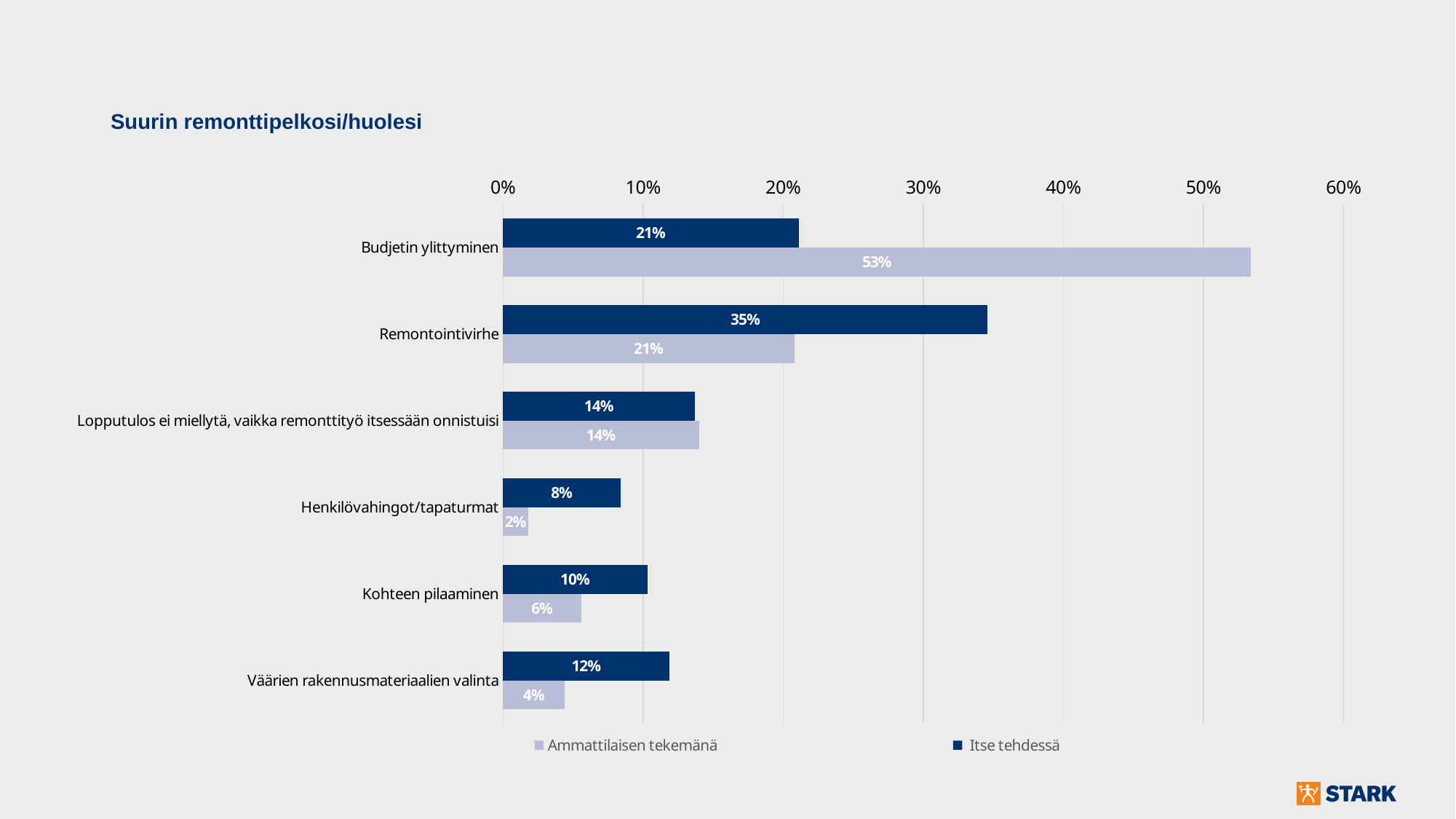
What is the value for "Remontointivirhe" in the "Itse tehdessä" series? 35% Is the "Ammattilaisen tekemänä" value for "Budjetin ylittyminen" greater or less than 50%? greater What is the title of the chart? Suurin remonttipelkosi/huolesi Which category has the highest value in the "Itse tehdessä" series? Remontointivirhe Which category has the lowest value in the "Ammattilaisen tekemänä" series? Henkilövahingot/tapaturmat What kind of chart is shown on the slide? Bar chart What is the difference between the "Ammattilaisen tekemänä" and "Itse tehdessä" values for "Budjetin ylittyminen"? 32% How many series does the legend list? 2 For "Kohteen pilaaminen", which series has the larger value, "Ammattilaisen tekemänä" or "Itse tehdessä"? Itse tehdessä What is the value for "Henkilövahingot/tapaturmat" in the "Ammattilaisen tekemänä" series? 2% How many categories are shown on the chart? 6 What is the value for "Budjetin ylittyminen" in the "Ammattilaisen tekemänä" series? 53%